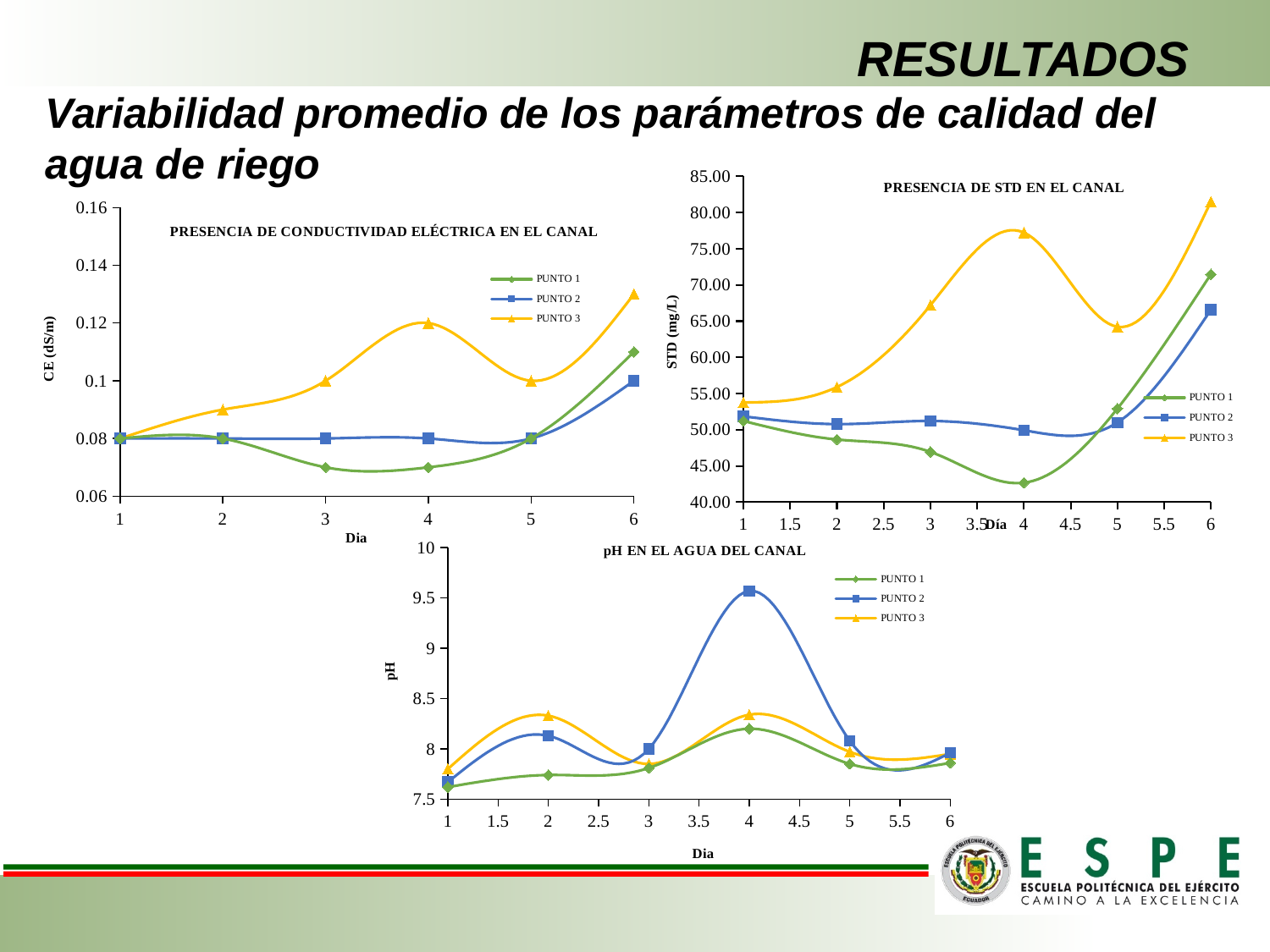
In the 'PRESENCIA DE CONDUCTIVIDAD ELÉCTRICA EN EL CANAL' chart, what is the CE value for PUNTO 2 on day 1? 0.08 In the 'pH EN EL AGUA DEL CANAL' chart, which series is higher on day 2, PUNTO 1 or PUNTO 3? PUNTO 3 In the 'PRESENCIA DE STD EN EL CANAL' chart, is the value for PUNTO 3 on day 6 greater or less than 80.00? greater In the 'pH EN EL AGUA DEL CANAL' chart, is the pH for PUNTO 2 on day 4 greater or less than 9.5? greater In the 'PRESENCIA DE STD EN EL CANAL' chart, which series has the lowest value on day 4? PUNTO 1 What is the y-axis label of the 'PRESENCIA DE STD EN EL CANAL' chart? STD (mg/L) How many series does the legend of the 'pH EN EL AGUA DEL CANAL' chart list? 3 In the 'PRESENCIA DE STD EN EL CANAL' chart, is the value for PUNTO 1 on day 4 greater or less than 45.00? less What type of chart is 'PRESENCIA DE CONDUCTIVIDAD ELÉCTRICA EN EL CANAL'? Line chart In the 'PRESENCIA DE CONDUCTIVIDAD ELÉCTRICA EN EL CANAL' chart, which series has the highest value on day 6? PUNTO 3 In the 'PRESENCIA DE CONDUCTIVIDAD ELÉCTRICA EN EL CANAL' chart, what is the CE value for PUNTO 3 on day 4? 0.12 In the 'PRESENCIA DE STD EN EL CANAL' chart, how many days are plotted along the x axis for each series? 6